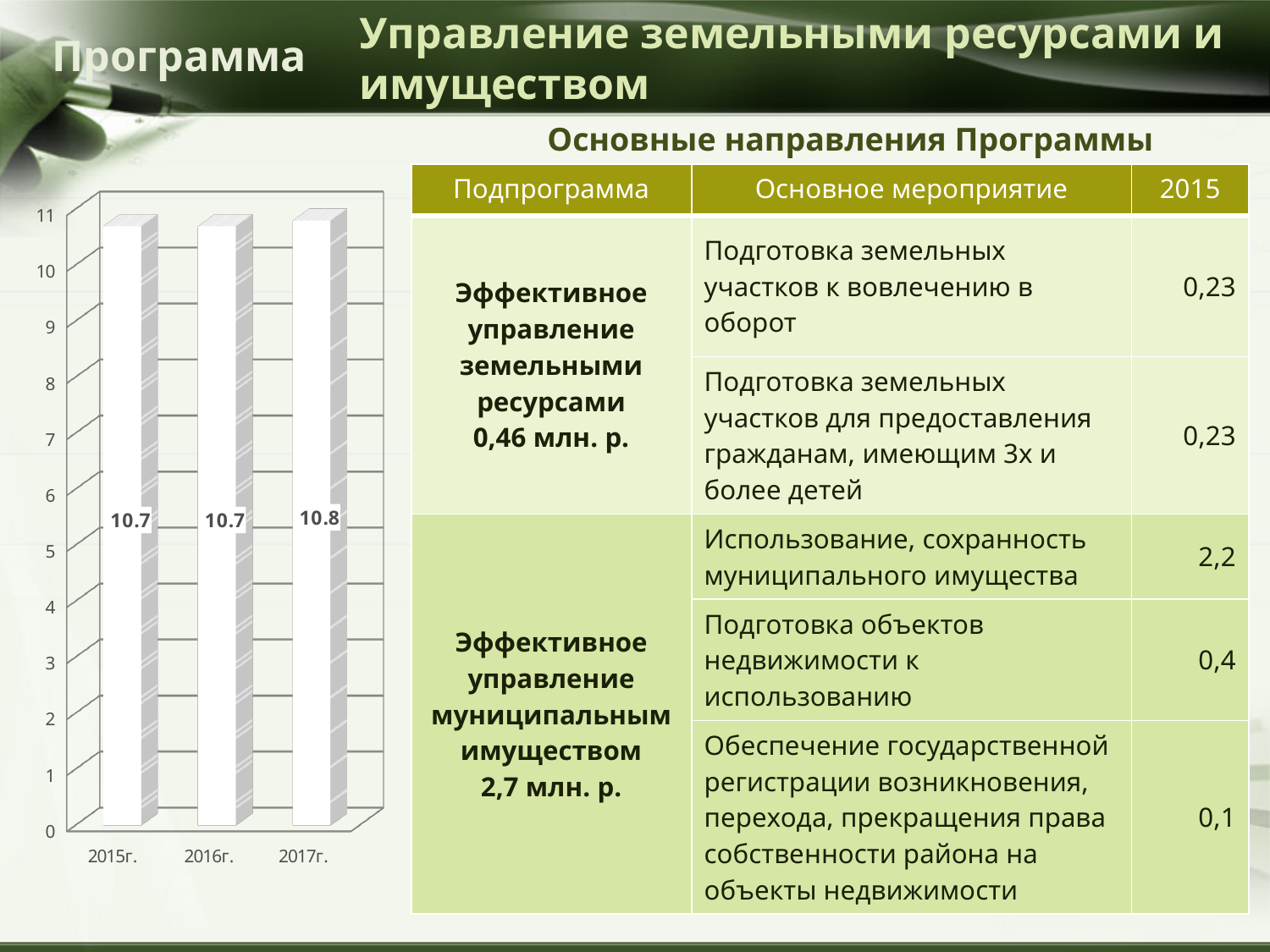
What kind of chart is shown on the left of the slide? bar chart What is the difference between the values for 2017г. and 2015г. in the bar chart? 0.1 What is the value for 2017г. in the bar chart? 10.8 What is the value for 2015г. in the bar chart? 10.7 Do the values in the bar chart rise or fall from 2015г. to 2017г.? rise Is the value for 2015г. in the bar chart greater or less than 10? greater What is the value for 2016г. in the bar chart? 10.7 Which year has the highest value in the bar chart? 2017г. What are the category labels on the horizontal axis of the bar chart? 2015г., 2016г., 2017г. How many bars are shown in the bar chart? 3 What is the highest tick value shown on the vertical axis of the bar chart? 11 Which is larger in the bar chart, the value for 2017г. or the value for 2016г.? 2017г.